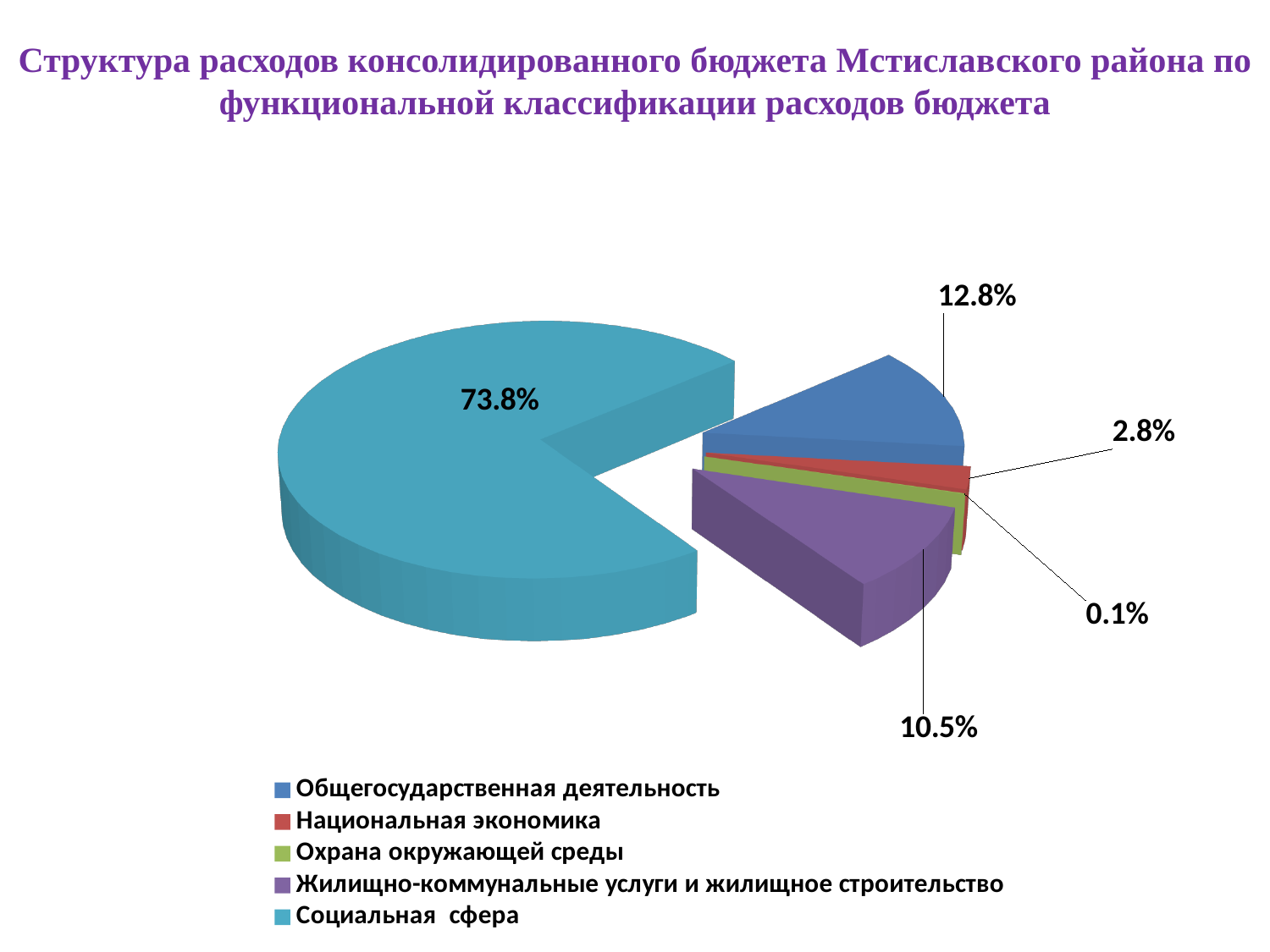
What is the value shown for Национальная экономика? 2.8% Which category has the largest share of the pie? Социальная сфера What share of the pie does Социальная сфера account for? 73.8% How many categories does the pie chart show? 5 What kind of chart is shown on the slide? Pie chart What is the value shown for Общегосударственная деятельность? 12.8% Which category has the smallest share of the pie? Охрана окружающей среды Which is larger: the share of Национальная экономика or the share of Жилищно-коммунальные услуги и жилищное строительство? Жилищно-коммунальные услуги и жилищное строительство Which colour represents Социальная сфера in the legend? Teal (light blue) What is the value shown for Охрана окружающей среды? 0.1% What is the difference between the shares of Общегосударственная деятельность and Жилищно-коммунальные услуги и жилищное строительство? 2.3% What is the value shown for Жилищно-коммунальные услуги и жилищное строительство? 10.5%